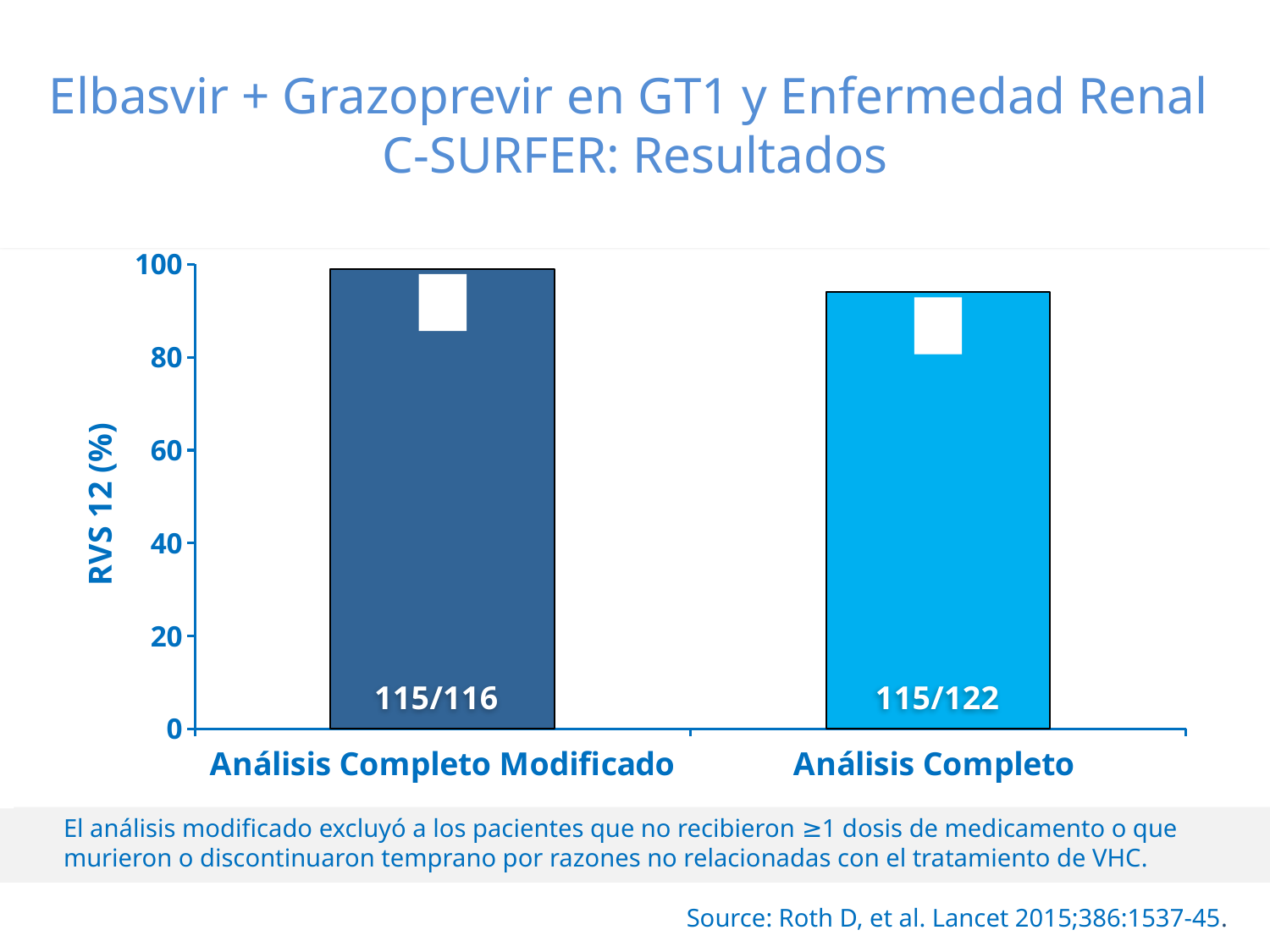
What fraction is printed on the bar for Análisis Completo? 115/122 Is the RVS 12 (%) value for Análisis Completo Modificado greater or less than 80? greater What is the maximum value shown on the vertical axis? 100 What kind of chart is shown on the slide? Bar chart What is the label of the vertical axis? RVS 12 (%) Which category has the lower RVS 12 (%) bar? Análisis Completo Which category has the higher RVS 12 (%) bar? Análisis Completo Modificado What fraction is printed on the bar for Análisis Completo Modificado? 115/116 How many categories are plotted on the chart? 2 Which bar is taller, Análisis Completo Modificado or Análisis Completo? Análisis Completo Modificado Is the RVS 12 (%) value for Análisis Completo greater or less than 80? greater